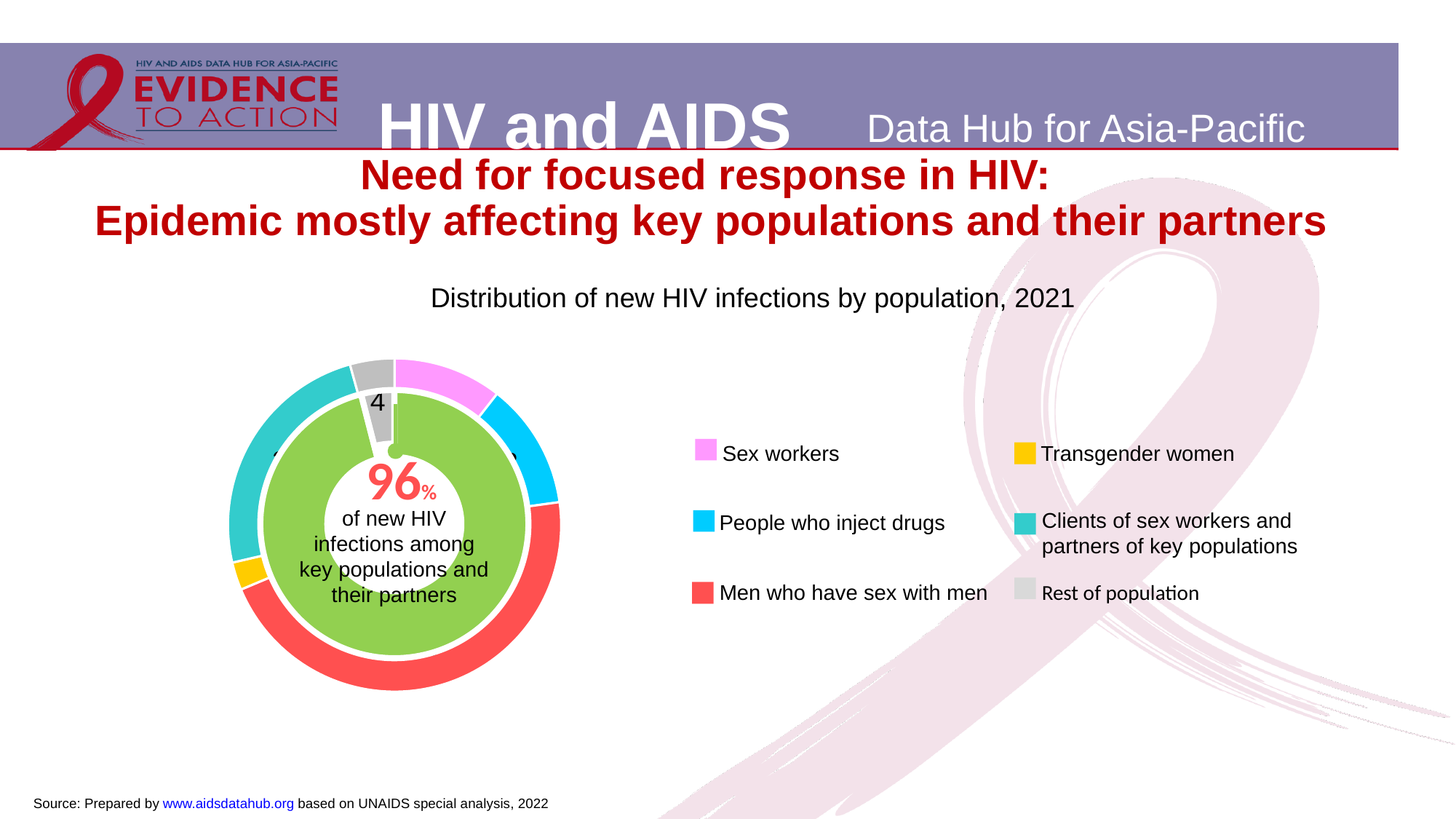
What is the title of the chart on the slide? Distribution of new HIV infections by population, 2021 Which slice is larger: Clients of sex workers and partners of key populations or Sex workers? Clients of sex workers and partners of key populations What share of the chart is labelled for Rest of population? 4 Which slice is larger: Men who have sex with men or Rest of population? Men who have sex with men How many population groups does the chart legend list? 6 What colour represents Men who have sex with men in the chart? Red What kind of chart is used to show the distribution of new HIV infections by population, 2021? Pie chart (donut) What value is printed on the chart for Rest of population? 4 Which slice is larger: Men who have sex with men or Sex workers? Men who have sex with men What percentage of new HIV infections is stated in the centre of the chart as being among key populations and their partners? 96% Which population group has the largest slice of the chart? Men who have sex with men